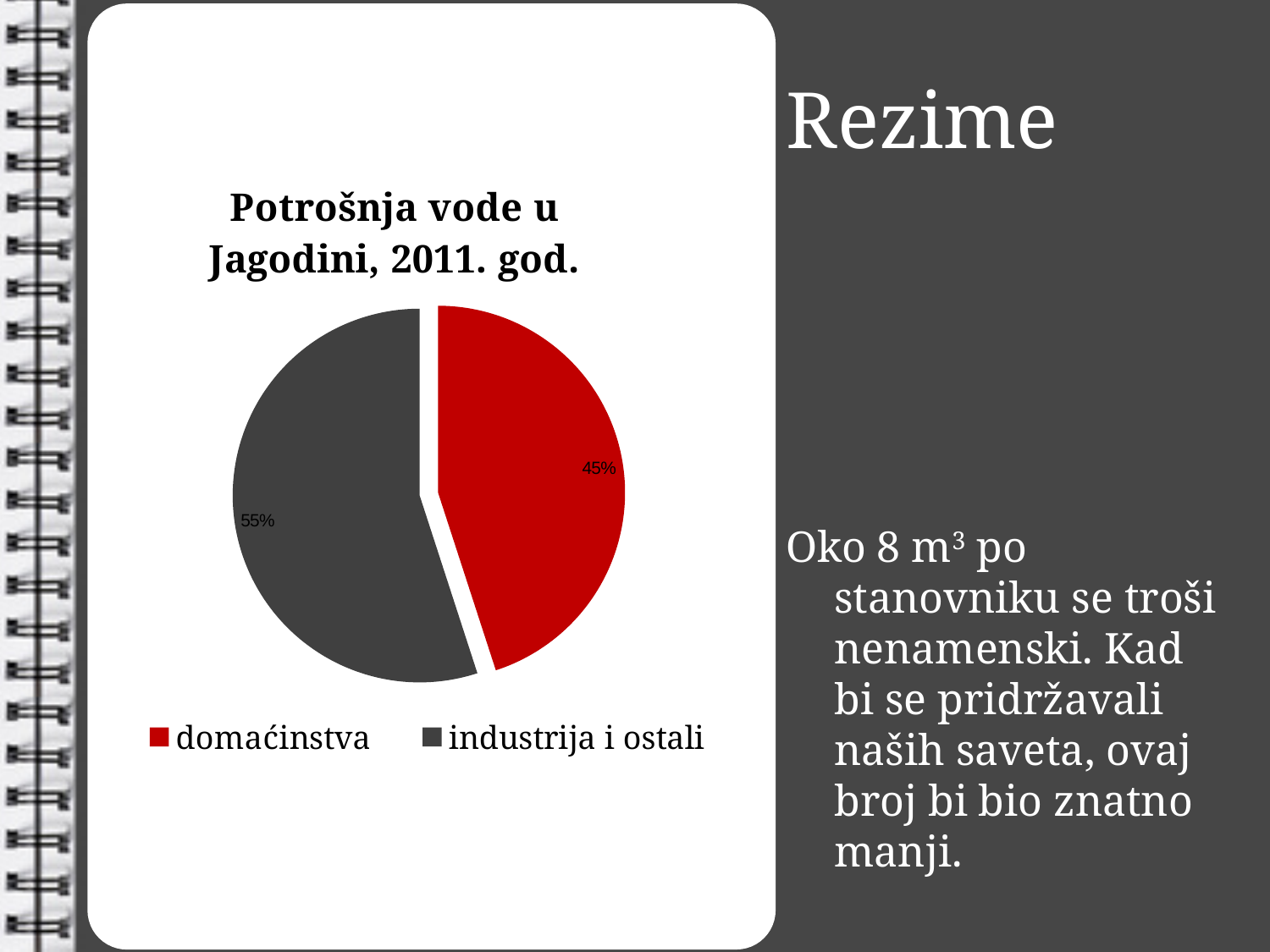
Which category has the largest slice of the pie? industrija i ostali What share of the pie does industrija i ostali have? 55% What is the title of the chart? Potrošnja vode u Jagodini, 2011. god. How many categories does the pie chart show? 2 What is the difference in percentage points between industrija i ostali and domaćinstva? 10 percentage points Which category has the smallest slice of the pie? domaćinstva What kind of chart is shown on the slide? pie chart Which is larger, the slice for domaćinstva or the slice for industrija i ostali? industrija i ostali What share of the pie does domaćinstva have? 45% Is the share for domaćinstva greater or less than 50%? less What colour is the slice for domaćinstva? red